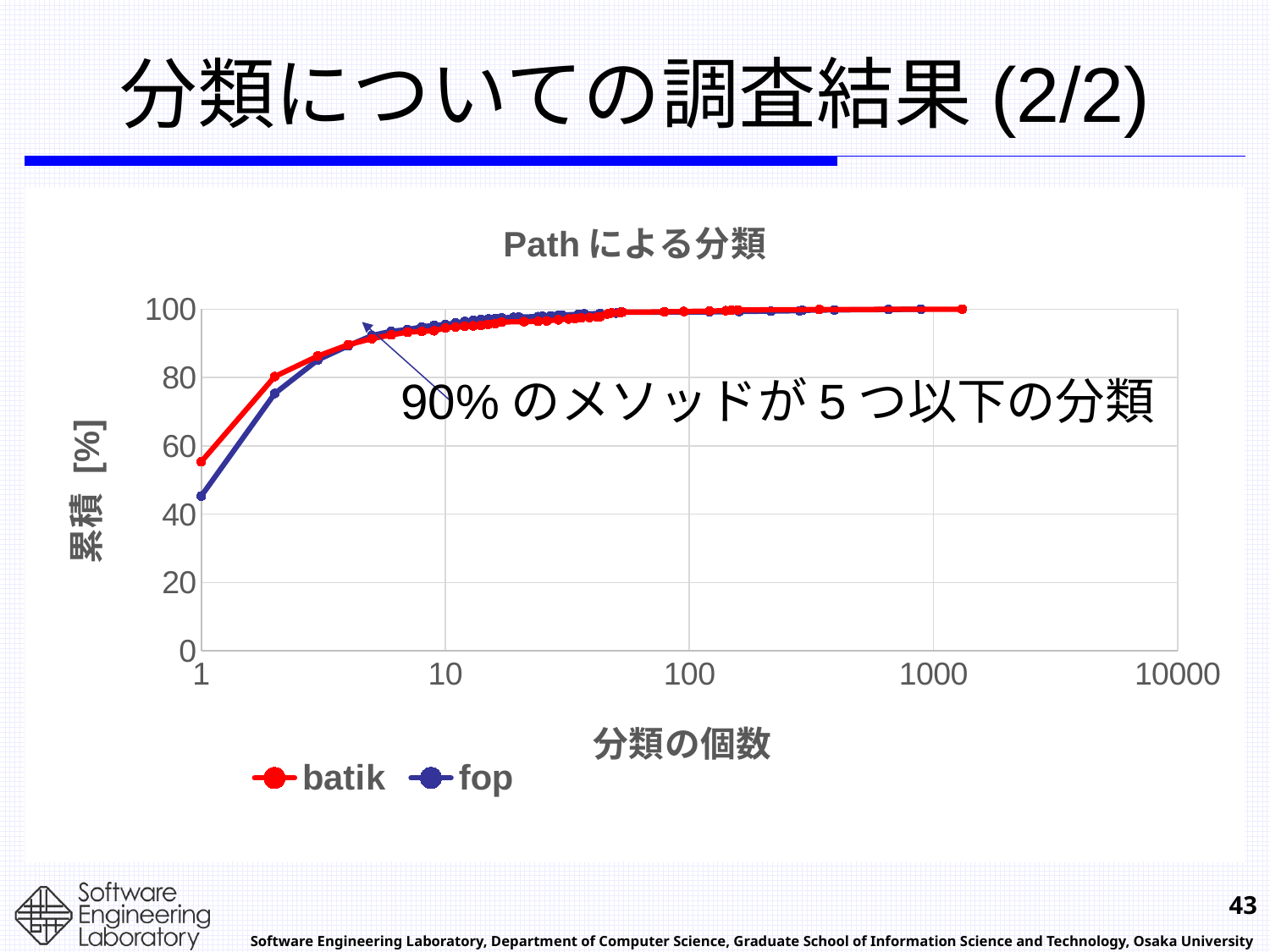
Is the value for fop at x = 1 greater or less than 60? less Which series is drawn in red? batik What kind of chart is shown on the slide? line chart At x = 1, which series has the larger value, batik or fop? batik Is the value for batik at x = 1 greater or less than 40? greater What is the label of the y axis? 累積 [%] What is the title of the chart? Path による分類 How many series does the legend list? 2 Is the value for batik at x = 10 greater or less than 80? greater Do the values rise or fall as the number of categories (分類の個数) increases along the x axis? rise